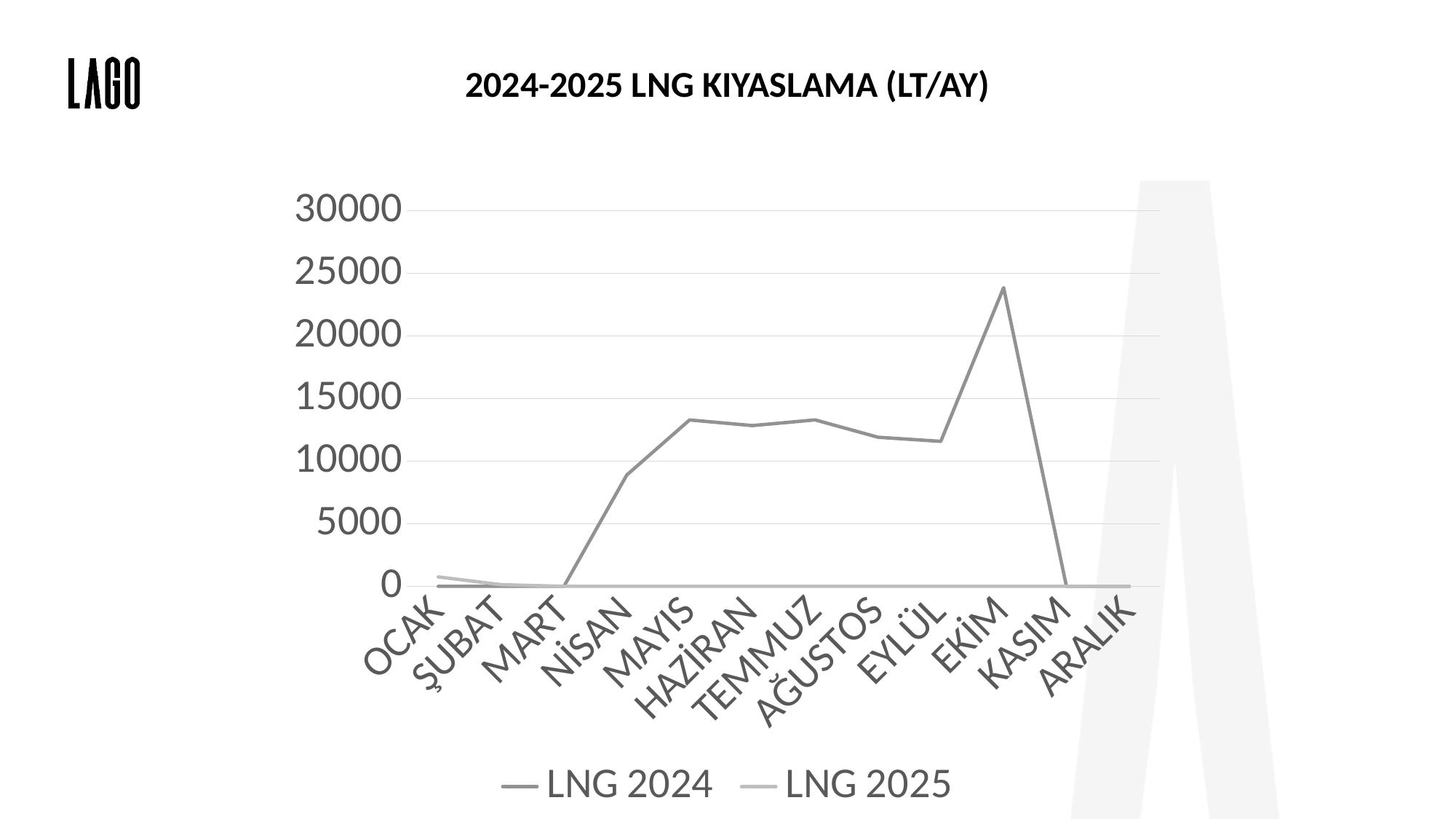
What is the title of the chart? 2024-2025 LNG KIYASLAMA (LT/AY) Does the LNG 2024 series rise or fall from EKİM to KASIM? fall What are the two series named in the legend? LNG 2024 and LNG 2025 How many months are shown on the x axis? 12 Is the LNG 2024 value for KASIM greater or less than 5000? less What kind of chart is shown on the slide? line chart Is the LNG 2024 value for NİSAN greater or less than 10000? less How many series does the legend list? 2 For the LNG 2024 series, which is larger: the value for EKİM or the value for MAYIS? EKİM Is the LNG 2024 value for MAYIS greater or less than 10000? greater In which month does the LNG 2024 series reach its highest value? EKİM